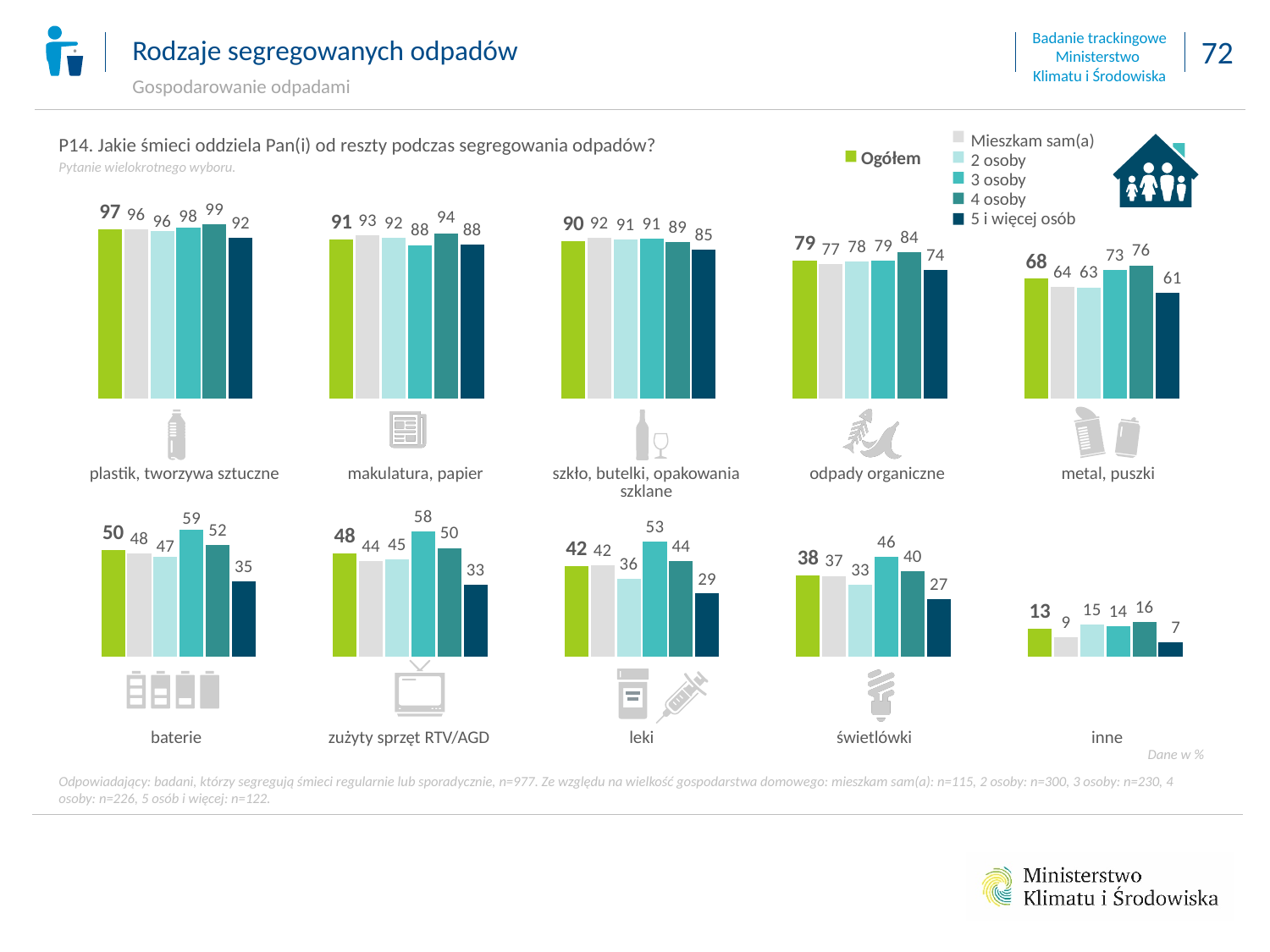
In the 'szkło, butelki, opakowania szklane' chart, what is the difference between the Ogółem value and the 5 i więcej osób value? 5 In the 'leki' chart, which household-size group has the highest value? 3 osoby How many small bar charts are shown on the slide? 10 In the 'baterie' chart, what is the value for 5 i więcej osób? 35 In the 'inne' chart, which group has the lowest value? 5 i więcej osób In the 'plastik, tworzywa sztuczne' chart, what is the value for Ogółem? 97 In the 'metal, puszki' chart, what is the difference between the 4 osoby value and the 5 i więcej osób value? 15 How many series does the legend list? 6 In the 'zużyty sprzęt RTV/AGD' chart, what is the value for 3 osoby? 58 What type of chart is used for 'odpady organiczne'? bar chart Which legend entry is shown in light green (the first bar in each chart)? Ogółem In the 'świetlówki' chart, which is larger: the value for 3 osoby or the value for Mieszkam sam(a)? 3 osoby